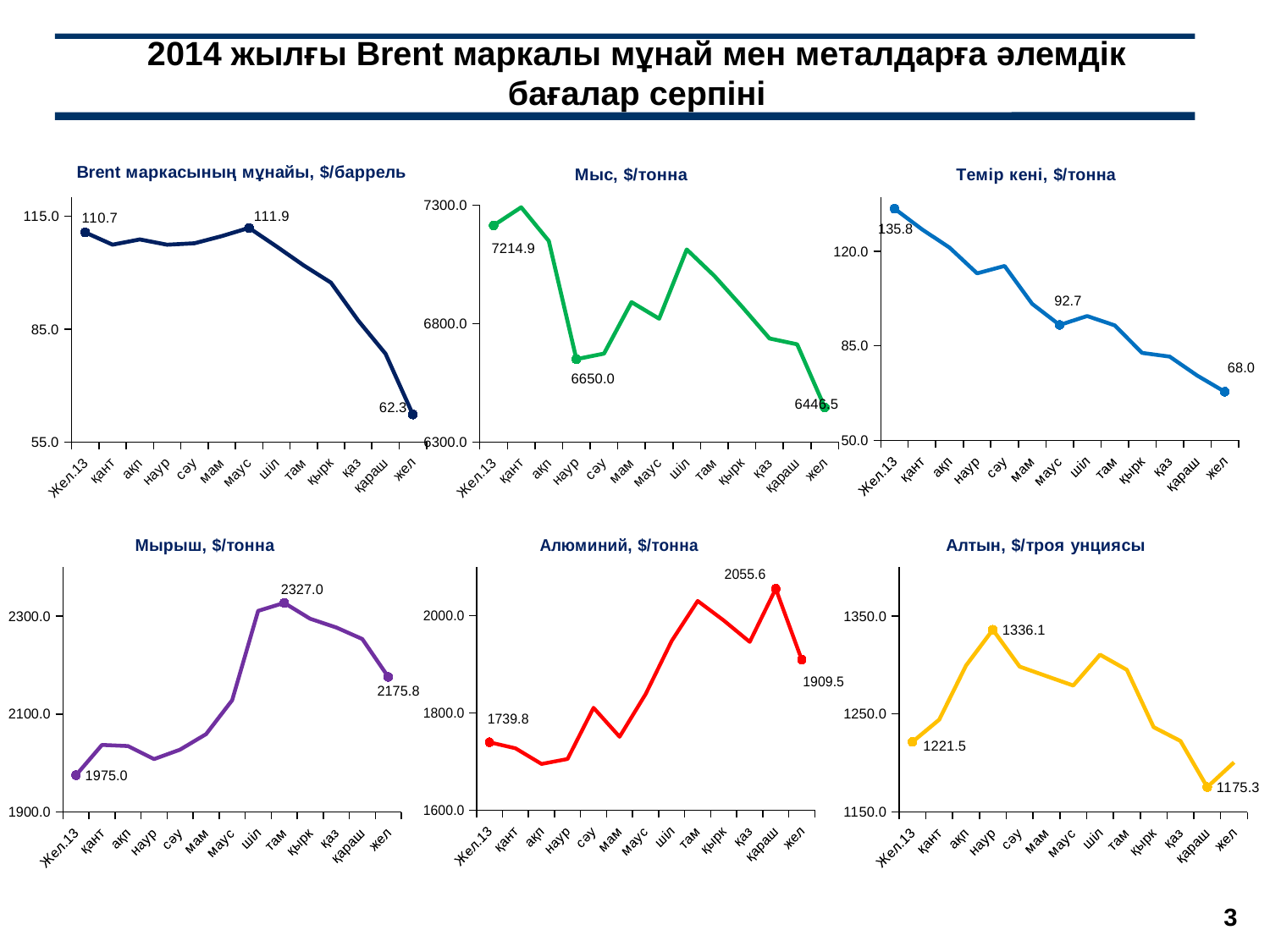
On the Brent маркасының мұнайы chart, is the value for қараш greater or less than 85.0? less On the Алтын, $/троя унциясы chart, what is the value for қараш? 1175.3 On the Мыс, $/тонна chart, what is the value for наур? 6650.0 On the Мыс, $/тонна chart, which month has the lowest value? жел On the Алюминий, $/тонна chart, which is larger: the value for Жел.13 or the value for жел? жел On the Brent маркасының мұнайы chart, what is the difference between the маус value and the жел value? 49.6 On the Мырыш, $/тонна chart, which month has the highest value? там On the Алюминий, $/тонна chart, which month has the highest value? қараш What kind of chart is the Алтын, $/троя унциясы chart? line chart On the Brent маркасының мұнайы chart, what is the value for Жел.13? 110.7 On the Темір кені, $/тонна chart, what is the value for жел? 68.0 On the Темір кені, $/тонна chart, what is the difference between the Жел.13 value and the жел value? 67.8